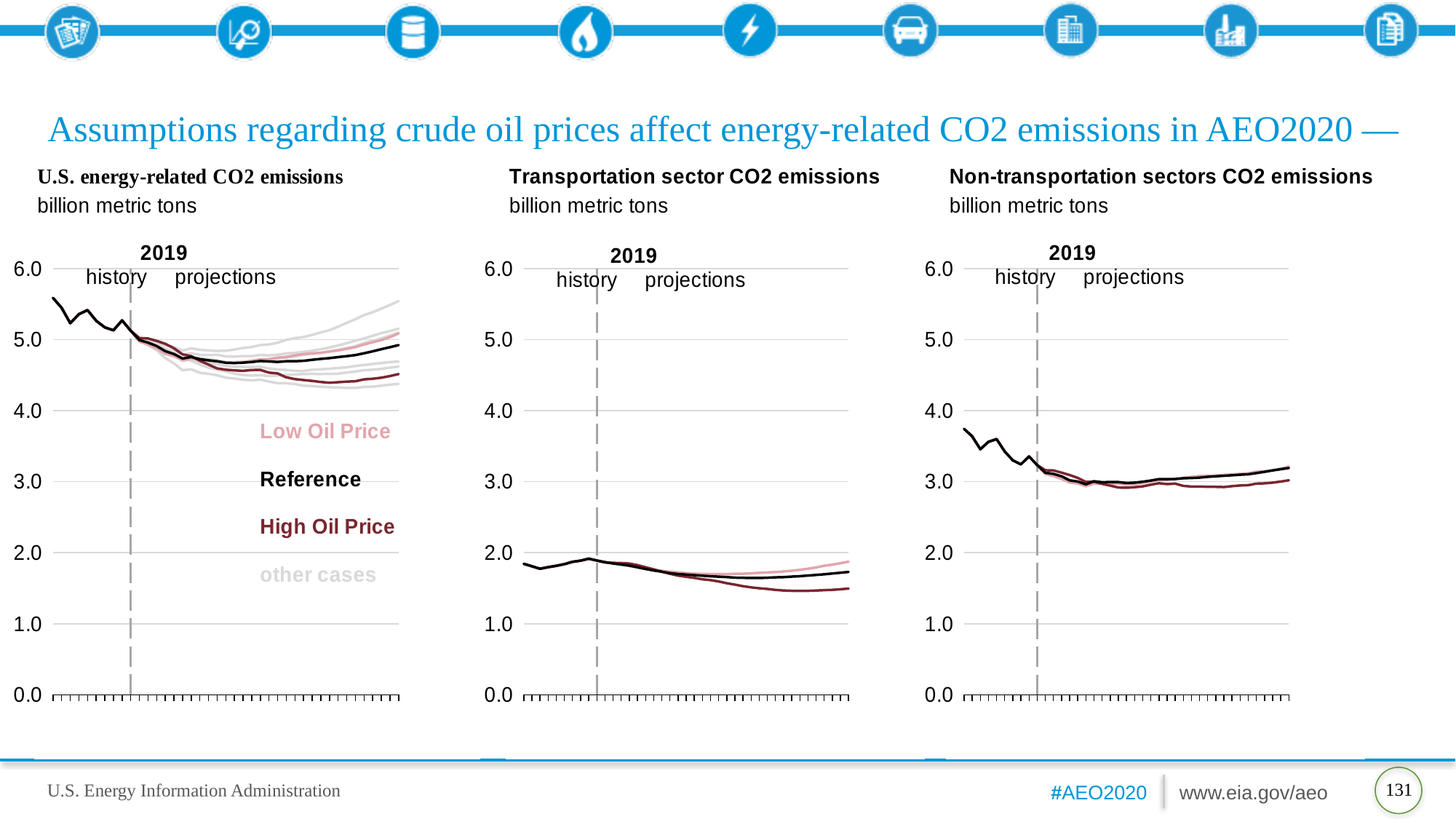
In the 'Non-transportation sectors CO2 emissions' chart, is the value at the start of the history period greater or less than 3.0? greater In the 'U.S. energy-related CO2 emissions' chart, do values rise or fall over the history period? fall In the 'U.S. energy-related CO2 emissions' chart, how many entries does the legend list? 4 In the 'U.S. energy-related CO2 emissions' chart, is the value at the start of the history period greater or less than 5.0? greater What kind of chart is the 'U.S. energy-related CO2 emissions' chart? line chart In the 'Non-transportation sectors CO2 emissions' chart, do values rise or fall over the history period? fall How many charts are shown on the slide? 3 In the 'U.S. energy-related CO2 emissions' chart, at the end of the projection period, which is higher, Low Oil Price or High Oil Price? Low Oil Price What unit is given for the values in the three charts? billion metric tons In the 'U.S. energy-related CO2 emissions' chart, is the High Oil Price value at the end of the projection period greater or less than 5.0? less In the 'Transportation sector CO2 emissions' chart, at the end of the projection period, which is higher, Reference or High Oil Price? Reference